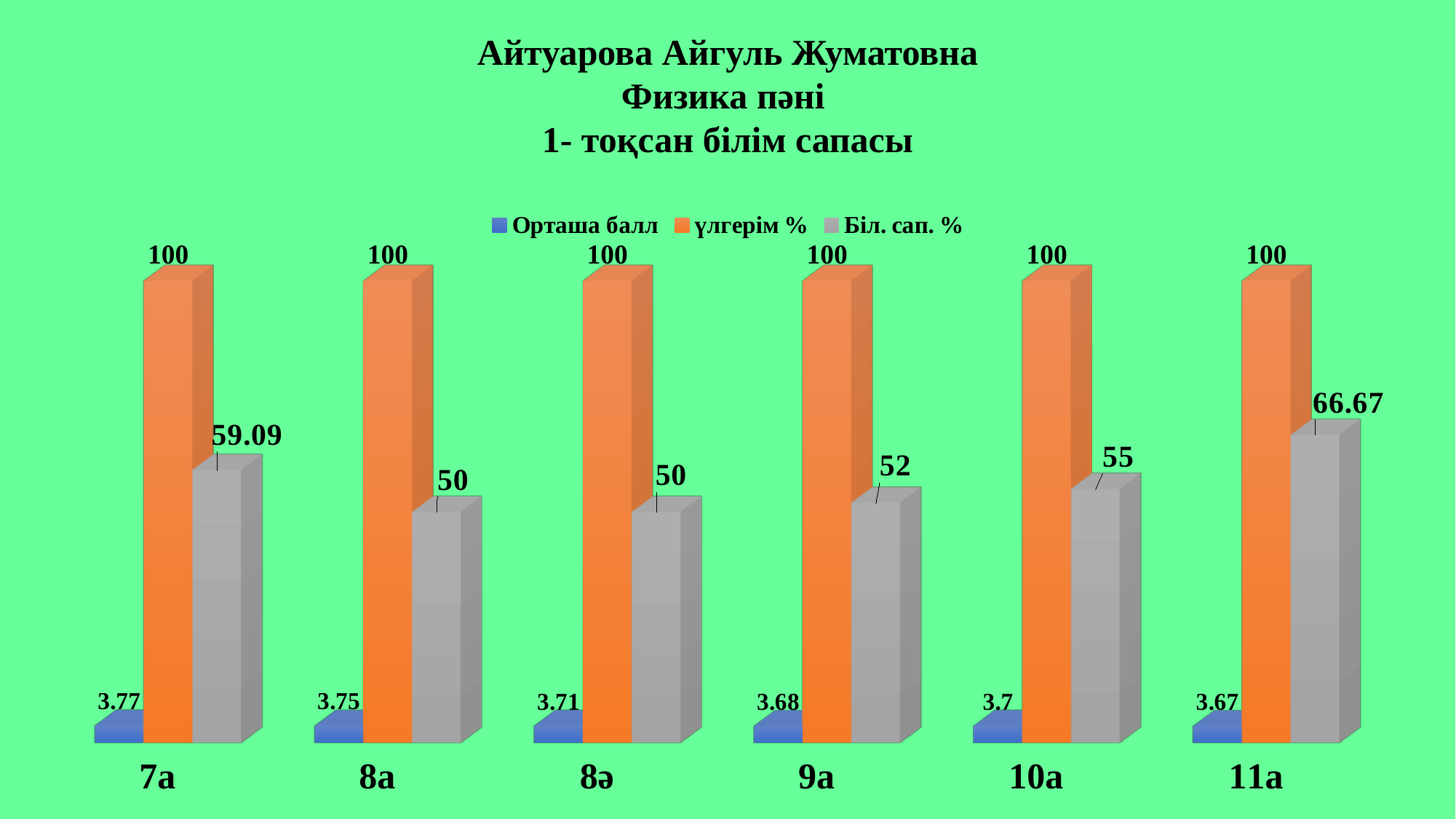
Which class has the lowest Орташа балл value? 11а How many classes are shown on the x axis? 6 How many series does the legend list? 3 Which colour represents the үлгерім % series in the legend? orange What is the үлгерім % value for 8ә? 100 What is the difference between the Біл. сап. % values for 11а and 7а? 7.58 Which class has the highest Біл. сап. % value? 11а Which is larger, the Біл. сап. % value for 10а or for 9а? 10а Do the Орташа балл values generally rise or fall from 7а to 11а? fall What is the Біл. сап. % value for 11а? 66.67 What kind of chart is shown on the slide? bar chart What is the Орташа балл value for 9а? 3.68